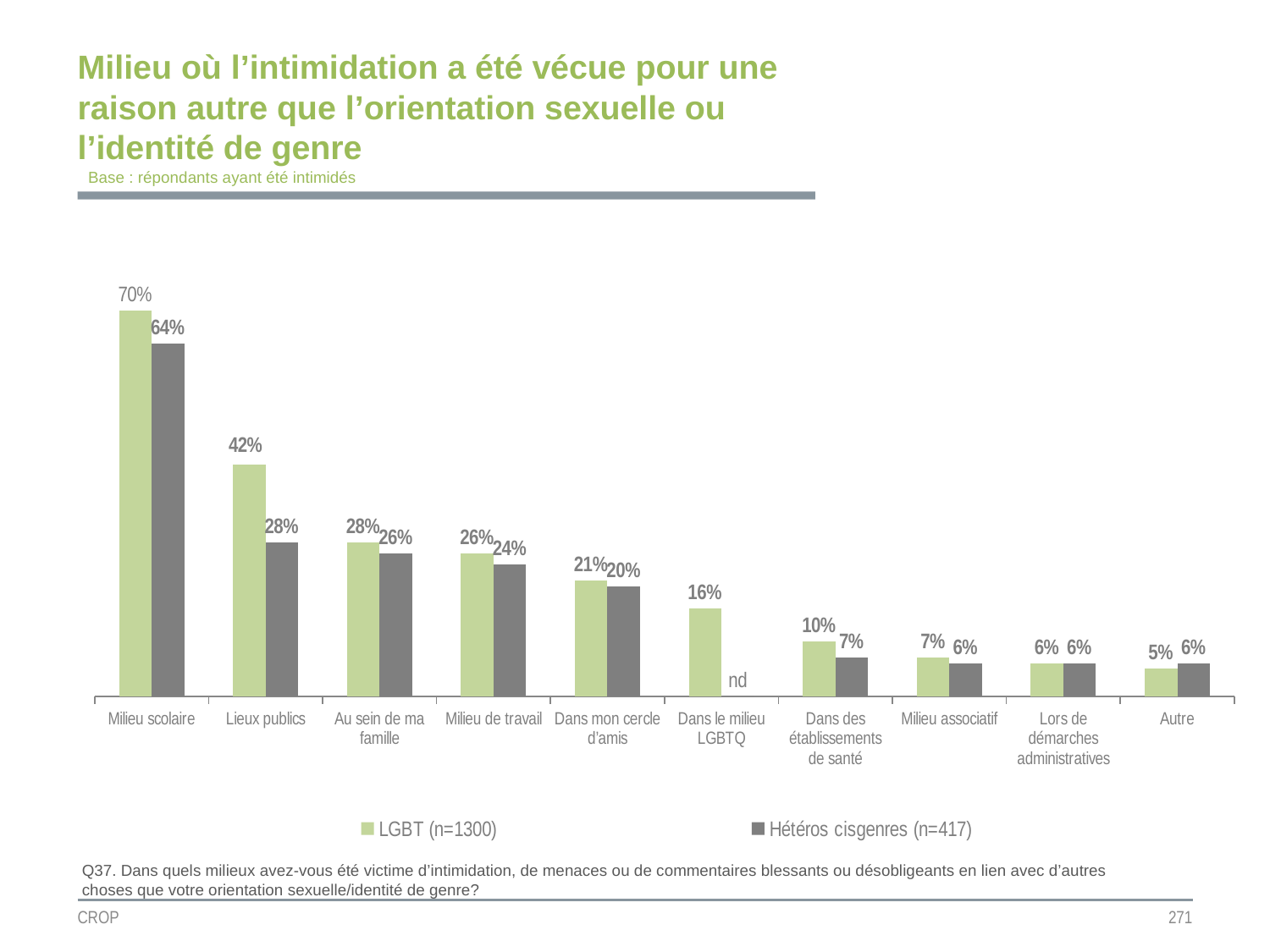
How many series does the legend list? 2 Which category has the highest value for LGBT (n=1300)? Milieu scolaire What is the value for LGBT (n=1300) in the Milieu scolaire category? 70% What is the difference between the LGBT (n=1300) and Hétéros cisgenres (n=417) values for Milieu scolaire? 6% What is the value for LGBT (n=1300) in the Dans le milieu LGBTQ category? 16% Which category has the lowest value for LGBT (n=1300)? Autre Which series has the larger value in the Autre category? Hétéros cisgenres (n=417) What is the value for Hétéros cisgenres (n=417) in the Lieux publics category? 28% What kind of chart is shown on the slide? Bar chart What is the difference between the LGBT (n=1300) and Hétéros cisgenres (n=417) values for Lieux publics? 14% What is shown for Hétéros cisgenres (n=417) in the Dans le milieu LGBTQ category? nd How many categories are shown on the x axis? 10